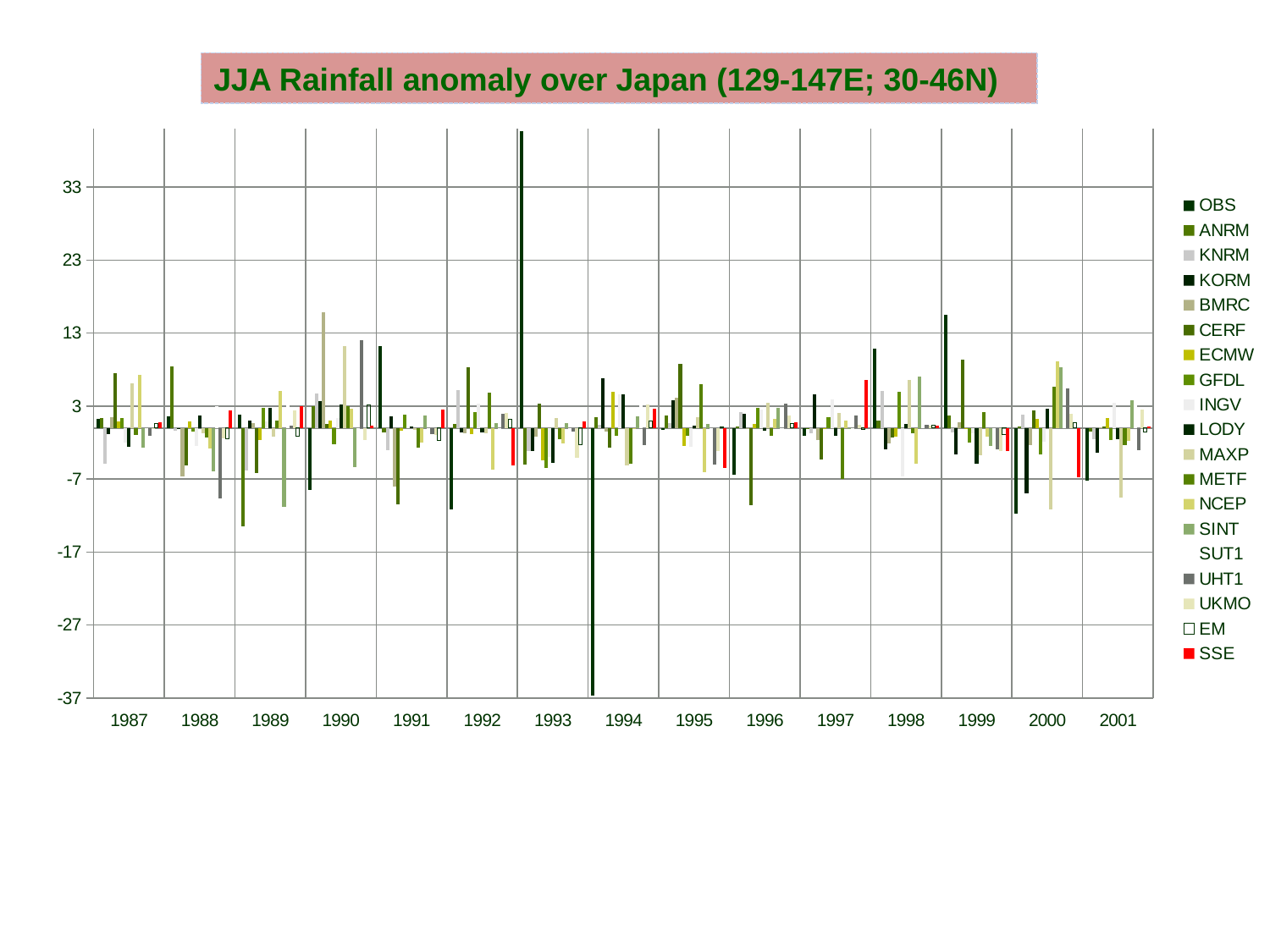
What is the first year shown on the x axis? 1987 Which year contains the lowest negative bar in the chart? 1994 What kind of chart is shown on the slide? bar chart Is the tallest bar in 1992 greater or less than 33? less What is the highest value labelled on the y axis? 33 What is the lowest value labelled on the y axis? -37 How many years are shown along the x axis? 15 Which year contains the tallest positive bar in the chart? 1993 How many series does the legend list? 19 Which series is drawn in red in the legend? SSE What is the title of the chart? JJA Rainfall anomaly over Japan (129-147E; 30-46N) Is the lowest bar in 1993 greater or less than -27? greater